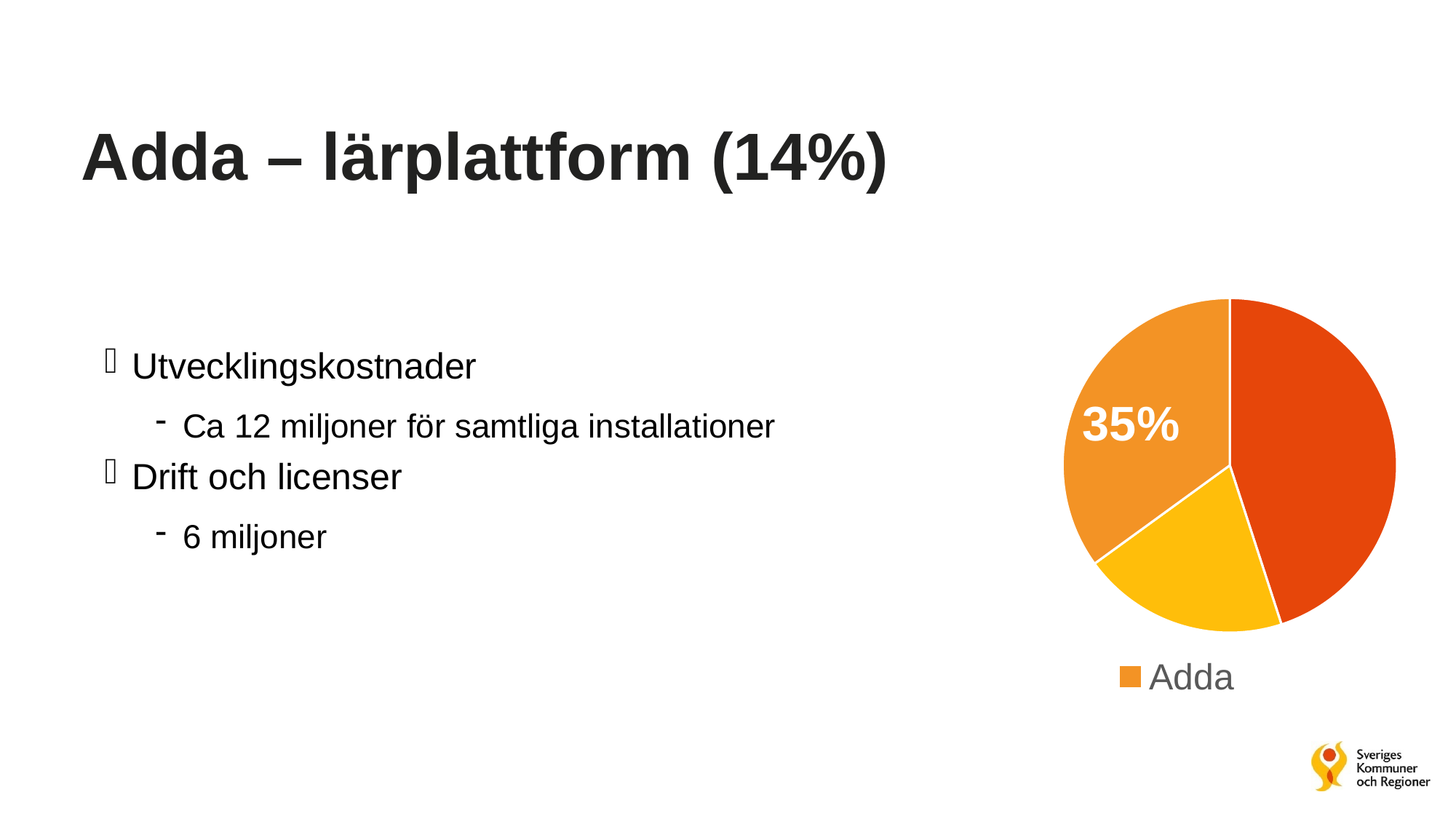
What is the only entry shown in the chart legend? Adda Is the Adda slice the largest slice of the pie chart? No Is the Adda slice larger or smaller than the yellow slice? larger What kind of chart is shown on the slide? pie chart What colour is the Adda slice in the pie chart? orange How many slices does the pie chart have? 3 How many slices of the pie chart have a printed data label? 1 Is the Adda slice larger or smaller than the dark orange slice? smaller What percentage is shown for the Adda slice of the pie chart? 35% Is the Adda slice greater or less than 50% of the pie? less What share of the pie does the Adda slice represent? 35% How many entries does the chart legend list? 1